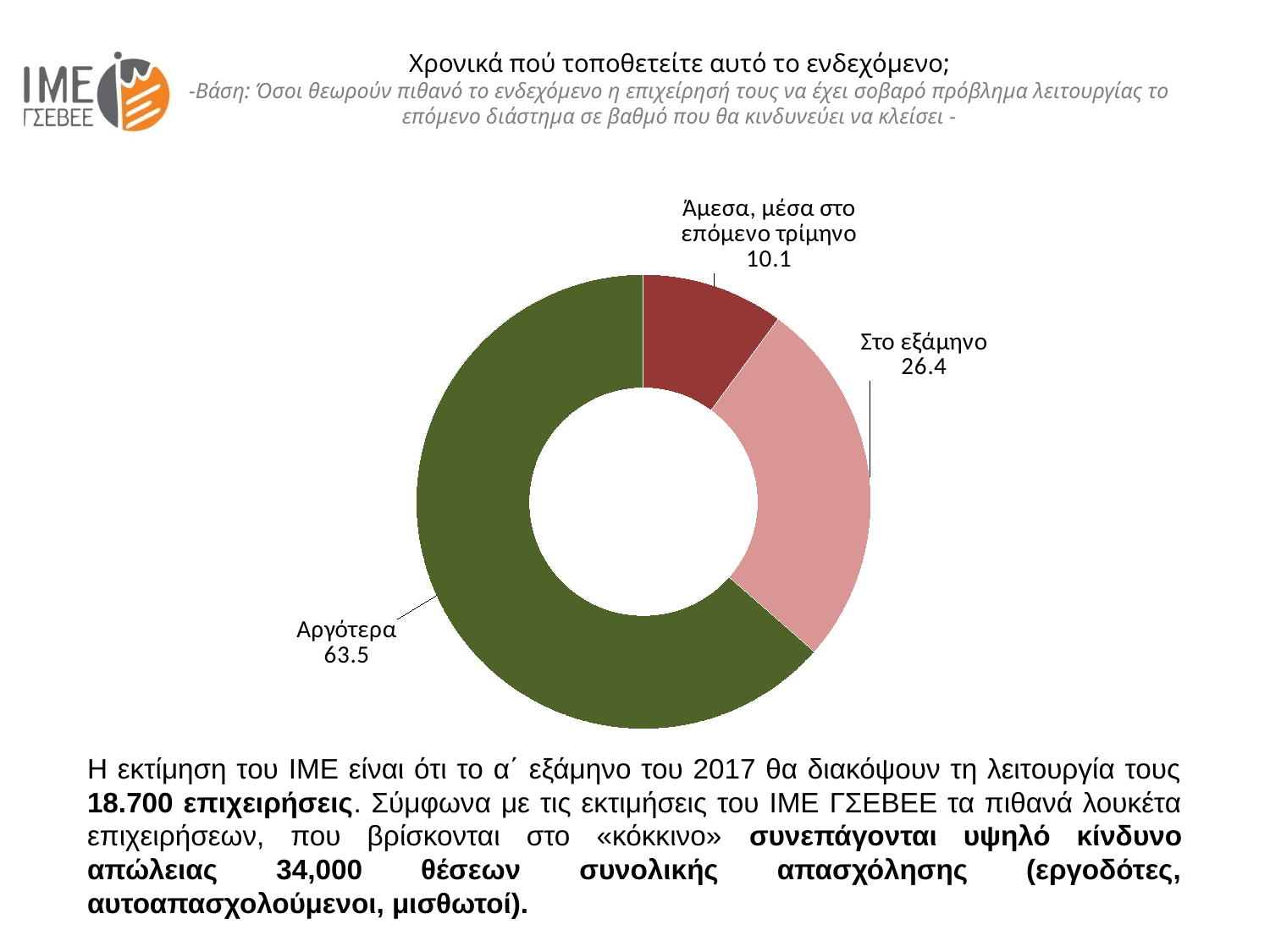
Which category has the smallest slice in the chart? Άμεσα, μέσα στο επόμενο τρίμηνο What value is shown for the slice labelled «Στο εξάμηνο»? 26.4 What colour is the slice for «Αργότερα»? dark green What kind of chart is shown on the slide? doughnut chart What value is shown for the slice labelled «Αργότερα»? 63.5 What value is shown for the slice labelled «Άμεσα, μέσα στο επόμενο τρίμηνο»? 10.1 Which is larger, the value for «Στο εξάμηνο» or the value for «Άμεσα, μέσα στο επόμενο τρίμηνο»? Στο εξάμηνο What is the difference between the values for «Στο εξάμηνο» and «Άμεσα, μέσα στο επόμενο τρίμηνο»? 16.3 Which category has the largest slice in the chart? Αργότερα What is the difference between the values for «Αργότερα» and «Στο εξάμηνο»? 37.1 How many categories (slices) does the chart show? 3 What is the title of the chart on the slide? Χρονικά πού τοποθετείτε αυτό το ενδεχόμενο;